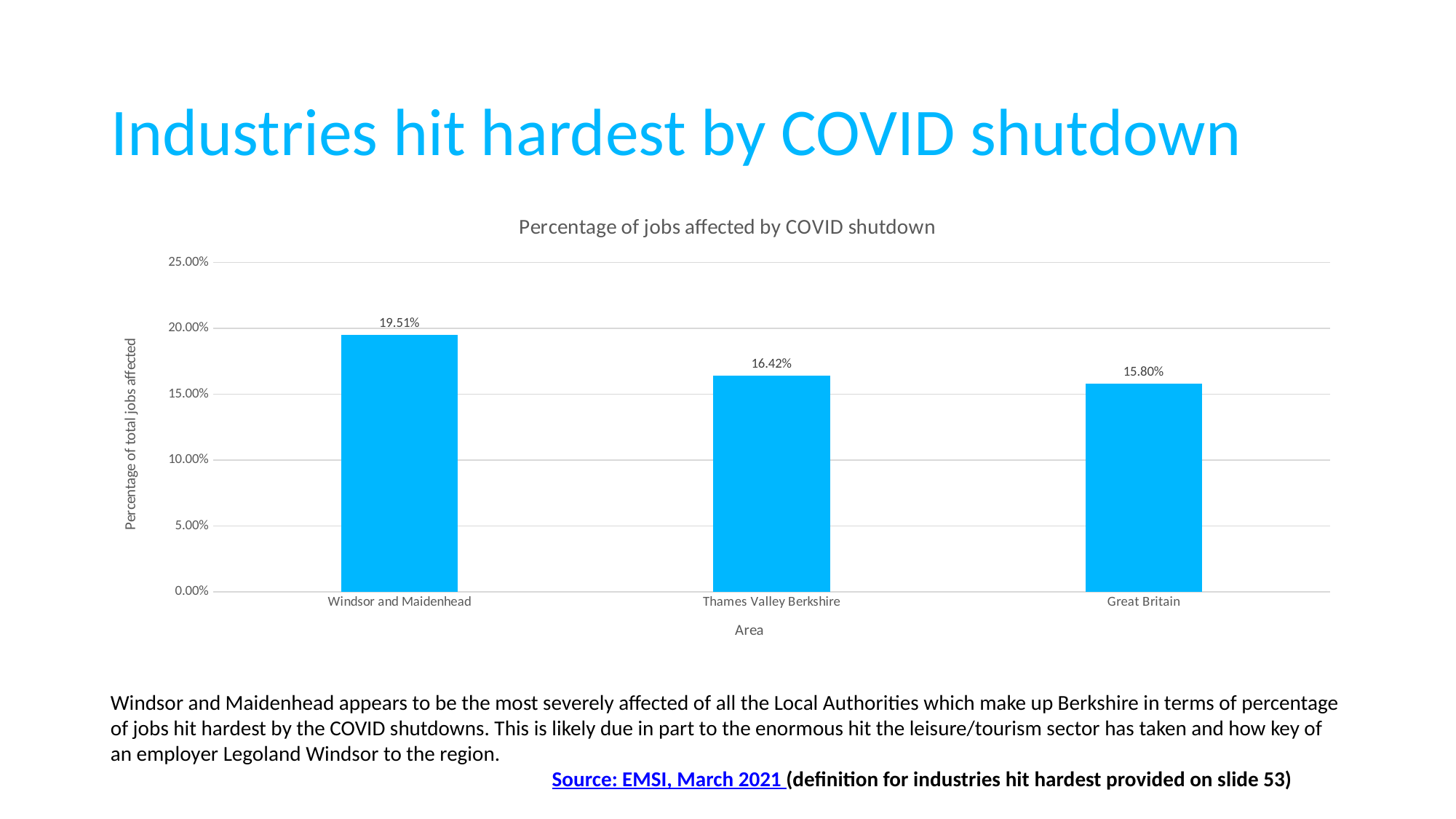
What kind of chart is shown on the slide? Bar chart What is the difference in percentage points between Thames Valley Berkshire and Great Britain? 0.62% Which area has the lowest percentage of jobs affected by COVID shutdown? Great Britain Which area has the highest percentage of jobs affected by COVID shutdown? Windsor and Maidenhead What is the percentage of jobs affected by COVID shutdown for Windsor and Maidenhead? 19.51% What is the title of the chart? Percentage of jobs affected by COVID shutdown Which has a higher percentage of jobs affected: Windsor and Maidenhead or Thames Valley Berkshire? Windsor and Maidenhead What is the percentage of jobs affected by COVID shutdown for Great Britain? 15.80% What is the percentage of jobs affected by COVID shutdown for Thames Valley Berkshire? 16.42% Is the value for Windsor and Maidenhead greater or less than 20.00%? less How many areas are shown in the chart? 3 What is the difference in percentage points between Windsor and Maidenhead and Great Britain? 3.71%